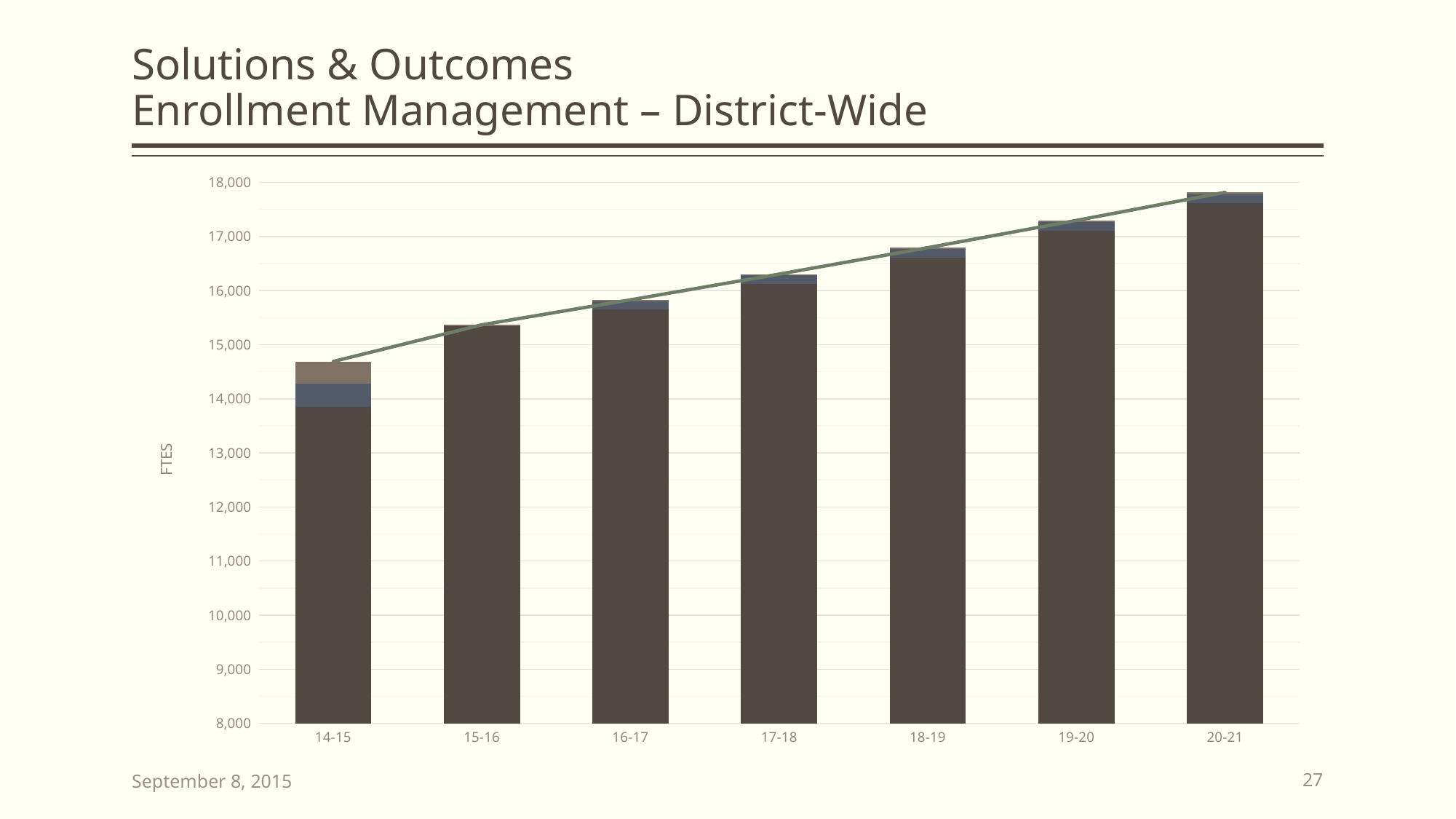
Which bar is taller, 17-18 or 15-16? 17-18 Is the total bar height for 20-21 greater or less than 18,000? less Is the total bar height for 14-15 greater or less than 15,000? less Is the total bar height for 15-16 greater or less than 15,000? greater Do the bar heights rise or fall from 14-15 to 20-21? rise Which academic year has the shortest bar in the chart? 14-15 Which academic year has the tallest bar in the chart? 20-21 What is the label on the vertical axis of the chart? FTES What kind of chart is shown on the slide? combination bar and line chart How many academic years are shown on the x axis of the chart? 7